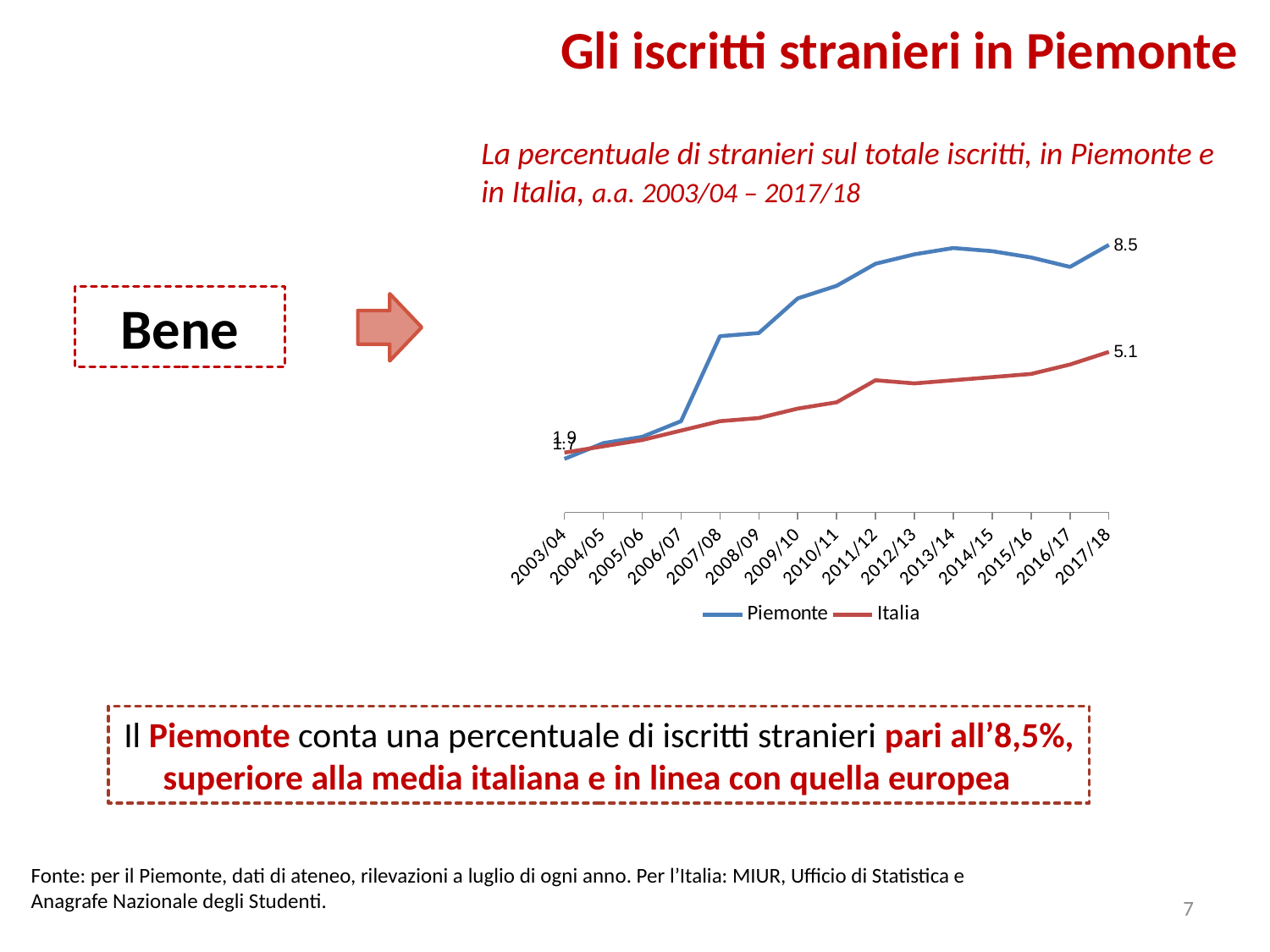
What kind of chart is shown on the slide? Line chart What is the difference between the Piemonte and Italia values in 2017/18? 3.4 Which series is drawn in blue? Piemonte In 2017/18, which series has the larger value, Piemonte or Italia? Piemonte What is the value for Piemonte in 2017/18? 8.5 What is the value for Italia in 2017/18? 5.1 What are the two entries in the chart legend? Piemonte and Italia Does the Italia line rise or fall overall from 2003/04 to 2017/18? Rise How many series does the legend list? 2 How many academic years are shown on the x axis? 15 Which series is higher in 2013/14, Piemonte or Italia? Piemonte Does the Piemonte line rise or fall overall from 2003/04 to 2017/18? Rise